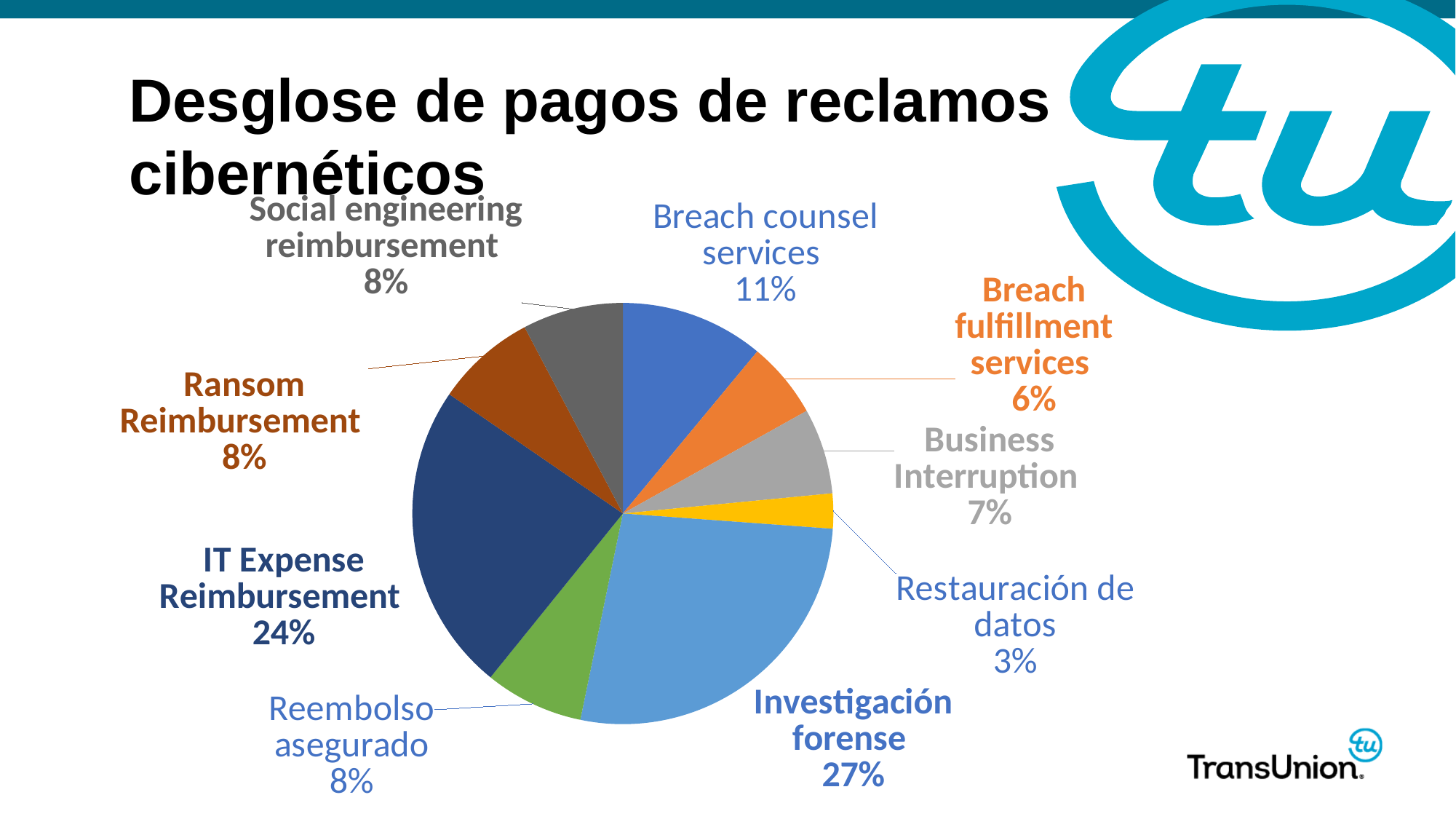
Which category has the smallest share of the pie? Restauración de datos What percentage is shown for Breach counsel services? 11% How many slices does the pie chart have? 9 What share of cyber claim payments goes to Investigación forense? 27% What is the title of the slide containing the chart? Desglose de pagos de reclamos cibernéticos What kind of chart is shown on the slide? pie chart What percentage is shown for Business Interruption? 7% What is the difference in percentage points between Investigación forense and IT Expense Reimbursement? 3 Which category has the largest share of the pie? Investigación forense What is the combined share of Ransom Reimbursement and Social engineering reimbursement? 16% Which is larger, Breach counsel services or Breach fulfillment services? Breach counsel services What percentage is shown for IT Expense Reimbursement? 24%